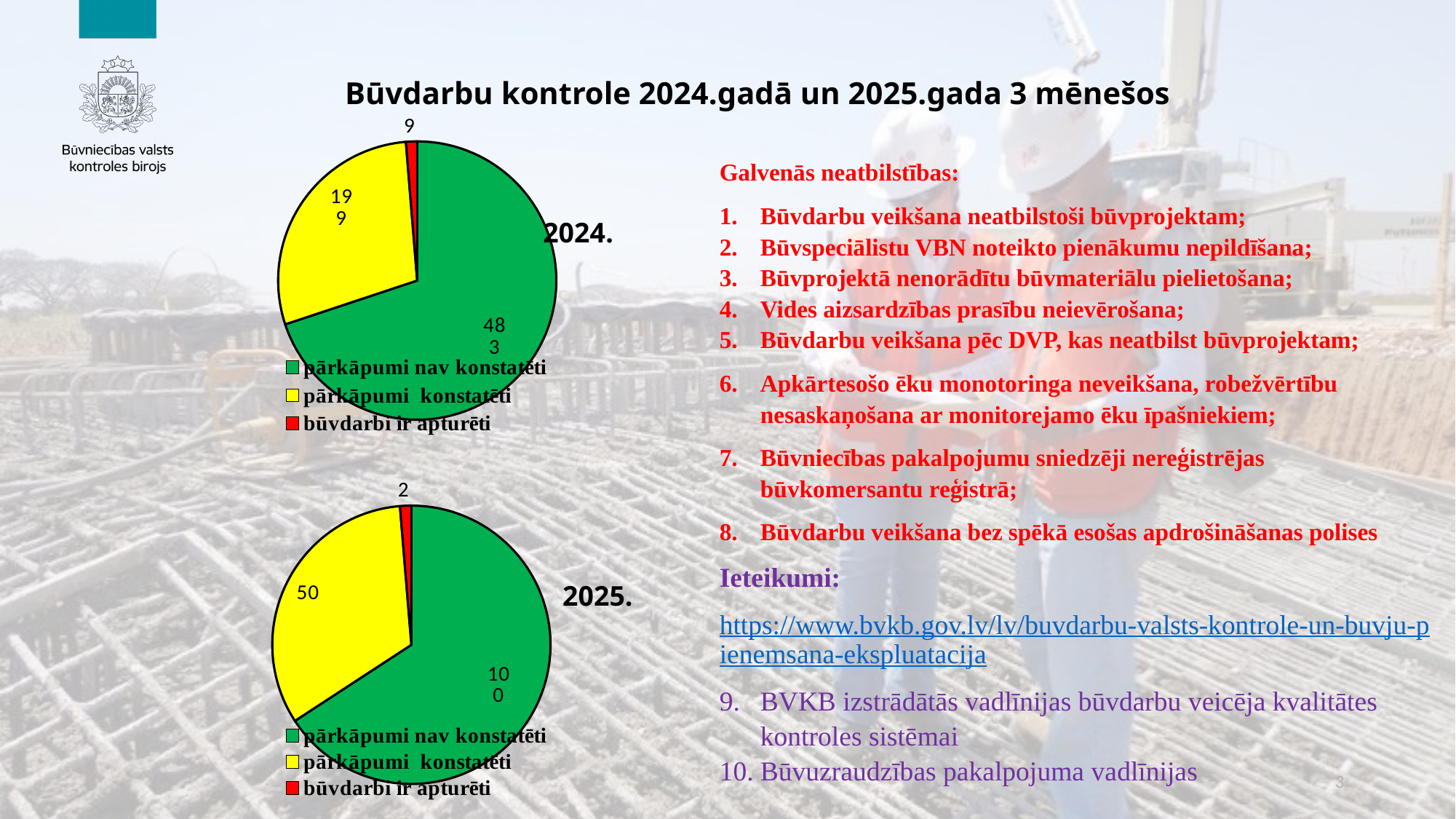
What kind of chart is the 2024. chart? pie chart In the 2025. chart, which is larger: 'pārkāpumi konstatēti' or 'būvdarbi ir apturēti'? pārkāpumi konstatēti How many entries does the legend of the 2024. chart list? 3 In the 2025. chart, what is the value for 'pārkāpumi konstatēti'? 50 How many slices does the 2025. pie chart have? 3 In the 2025. chart, what is the value for 'būvdarbi ir apturēti'? 2 What is the difference between the 'būvdarbi ir apturēti' value in the 2024. chart and in the 2025. chart? 7 In the 2025. chart, which category has the smallest slice? būvdarbi ir apturēti In the 2025. chart, which category has the largest slice? pārkāpumi nav konstatēti In the 2024. chart, which category has the largest slice? pārkāpumi nav konstatēti In the 2024. chart, which category has the smallest slice? būvdarbi ir apturēti In the 2024. chart, what is the value for 'būvdarbi ir apturēti'? 9